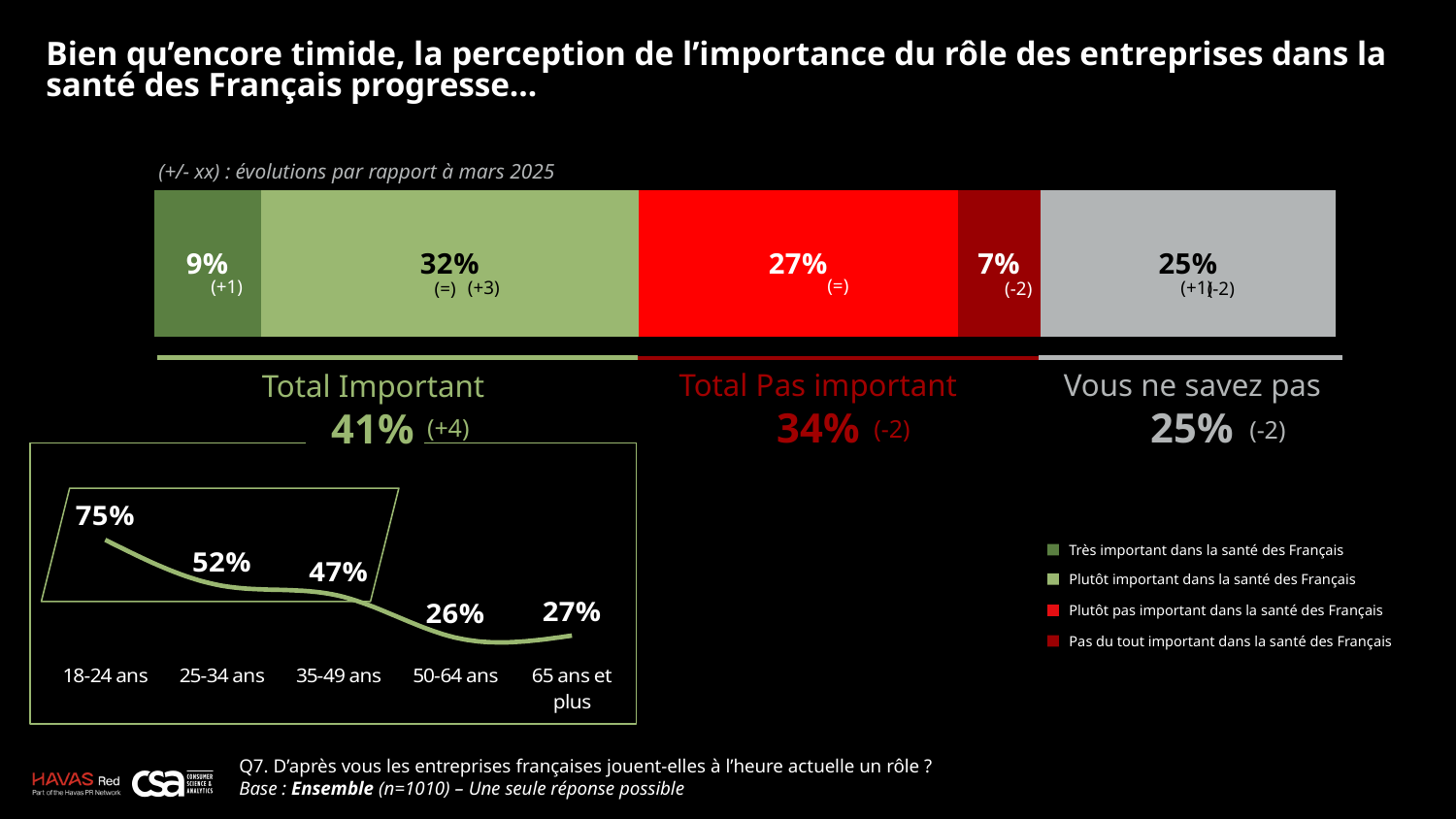
In the line chart by age group at the bottom left, which age group has the lowest value? 50-64 ans (26%) In the stacked bar at the top, what percentage is shown for 'Très important dans la santé des Français' (the dark green segment)? 9% In the line chart at the bottom left, does the value rise or fall from '18-24 ans' to '50-64 ans'? fall In the stacked bar at the top, which segment has the largest value? Plutôt important dans la santé des Français (32%) In the line chart by age group at the bottom left, what is the value for '18-24 ans'? 75% In the stacked bar at the top, what percentage is shown for 'Pas du tout important dans la santé des Français' (the dark red segment)? 7% In the stacked bar at the top, what is the difference between the 'Plutôt important' segment (32%) and the 'Très important' segment (9%)? 23 percentage points What kind of chart is shown at the bottom left of the slide? line chart How many entries does the legend on the right list? 4 How many age groups are plotted in the line chart at the bottom left? 5 In the stacked bar at the top, what is the combined 'Total Important' share shown below the bar? 41% In the stacked bar at the top, what percentage is shown for 'Plutôt important dans la santé des Français' (the light green segment)? 32%